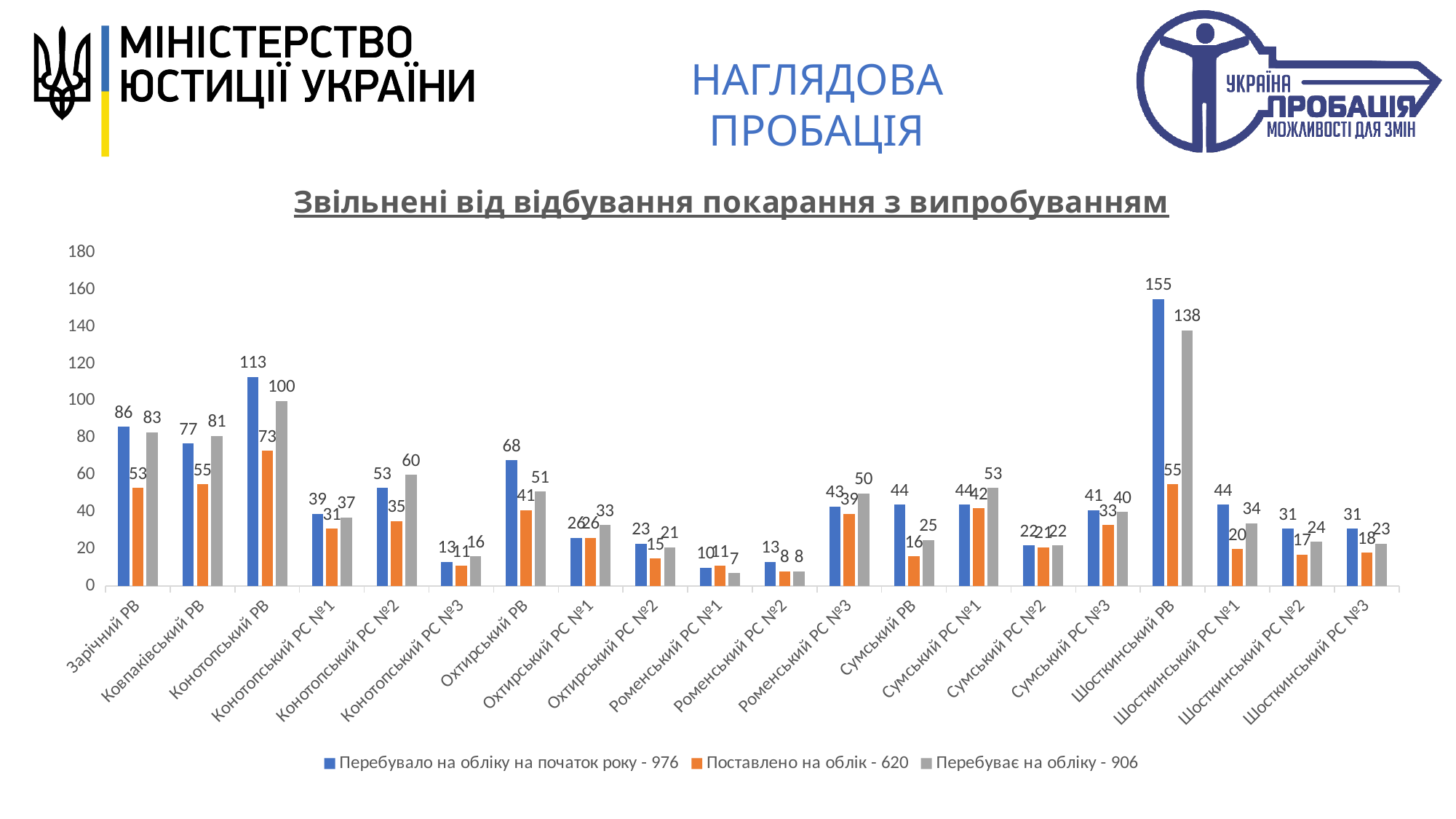
What is the value of 'Поставлено на облік' for Конотопський РВ? 73 What is the value of 'Перебувало на обліку на початок року' for Шосткинський РВ? 155 Is the value of 'Перебувало на обліку на початок року' for Конотопський РВ greater or less than 100? greater What type of chart is shown on the slide? bar chart Which category has the highest value for 'Перебуває на обліку'? Шосткинський РВ What is the difference between 'Перебувало на обліку на початок року' and 'Перебуває на обліку' for Шосткинський РВ? 17 How many series does the legend list? 3 Which is larger for Конотопський РС №2: 'Перебувало на обліку на початок року' or 'Перебуває на обліку'? Перебуває на обліку How many categories are shown on the x axis? 20 Which category has the lowest value for 'Перебуває на обліку'? Роменський РС №1 What is the title of the chart? Звільнені від відбування покарання з випробуванням What is the value of 'Перебуває на обліку' for Сумський РС №1? 53